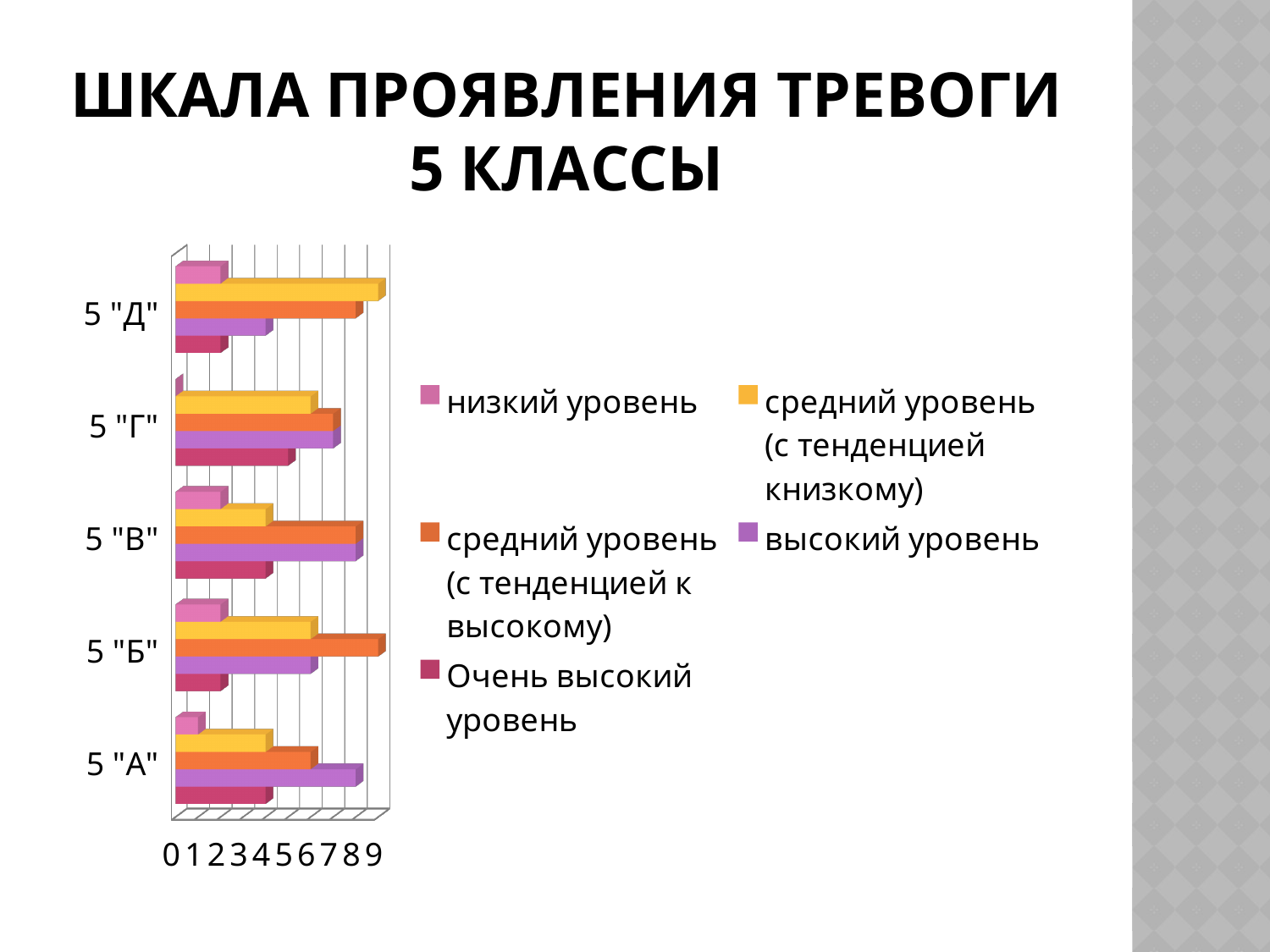
Which class has the highest value for "средний уровень (с тенденцией к низкому)"? 5 "Д" Which class has the lowest value for "низкий уровень"? 5 "Г" Is the value for "низкий уровень" in class 5 "Д" greater or less than 5? less What is the title of the slide with the chart? ШКАЛА ПРОЯВЛЕНИЯ ТРЕВОГИ 5 КЛАССЫ Is the value for "низкий уровень" in class 5 "Г" greater or less than 2? less How many classes (categories) are shown on the chart? 5 Is the value for "высокий уровень" in class 5 "А" greater or less than 5? greater Which colour represents the series "низкий уровень" in the legend? pink In class 5 "Д", which is larger: "средний уровень (с тенденцией к низкому)" or "высокий уровень"? средний уровень (с тенденцией к низкому) What kind of chart is shown on the slide? bar chart How many series does the legend list? 5